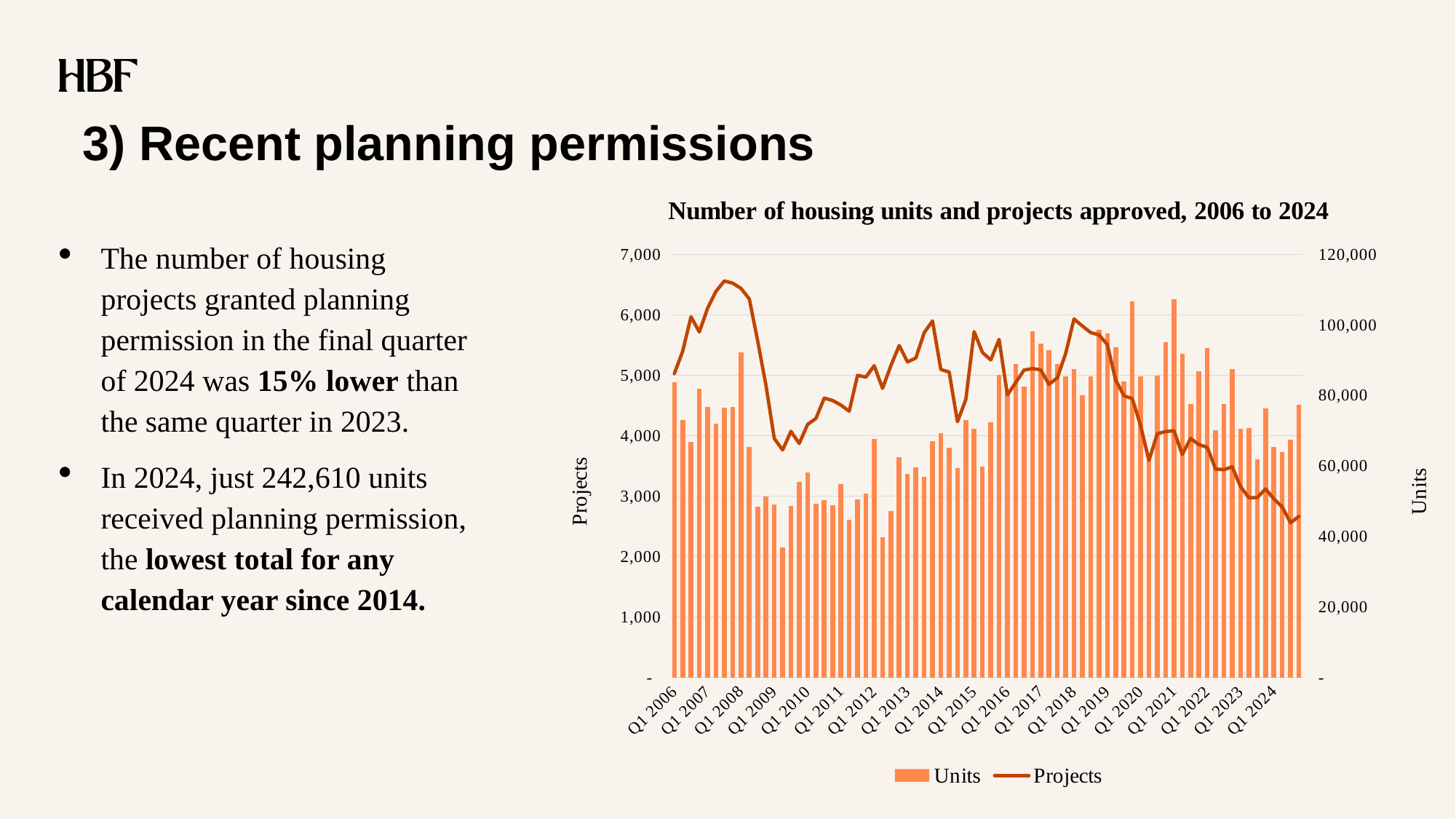
Is the Projects value at Q1 2006 greater or less than 4,000? greater Which series is plotted as a line rather than bars? Projects What is the title of the chart? Number of housing units and projects approved, 2006 to 2024 How many series does the chart legend list? 2 Which is larger, the Projects value at Q1 2006 or at Q1 2024? Q1 2006 Which is larger, the Units value at Q1 2008 or at Q1 2009? Q1 2008 Does the Projects line rise or fall between Q1 2006 and Q1 2008? rise Is the Units value at Q1 2009 greater or less than 60,000? less Does the Projects line rise or fall between Q1 2019 and Q1 2024? fall Is the Units value at Q1 2006 greater or less than 60,000? greater What kind of chart is shown on the slide? Combined bar and line chart